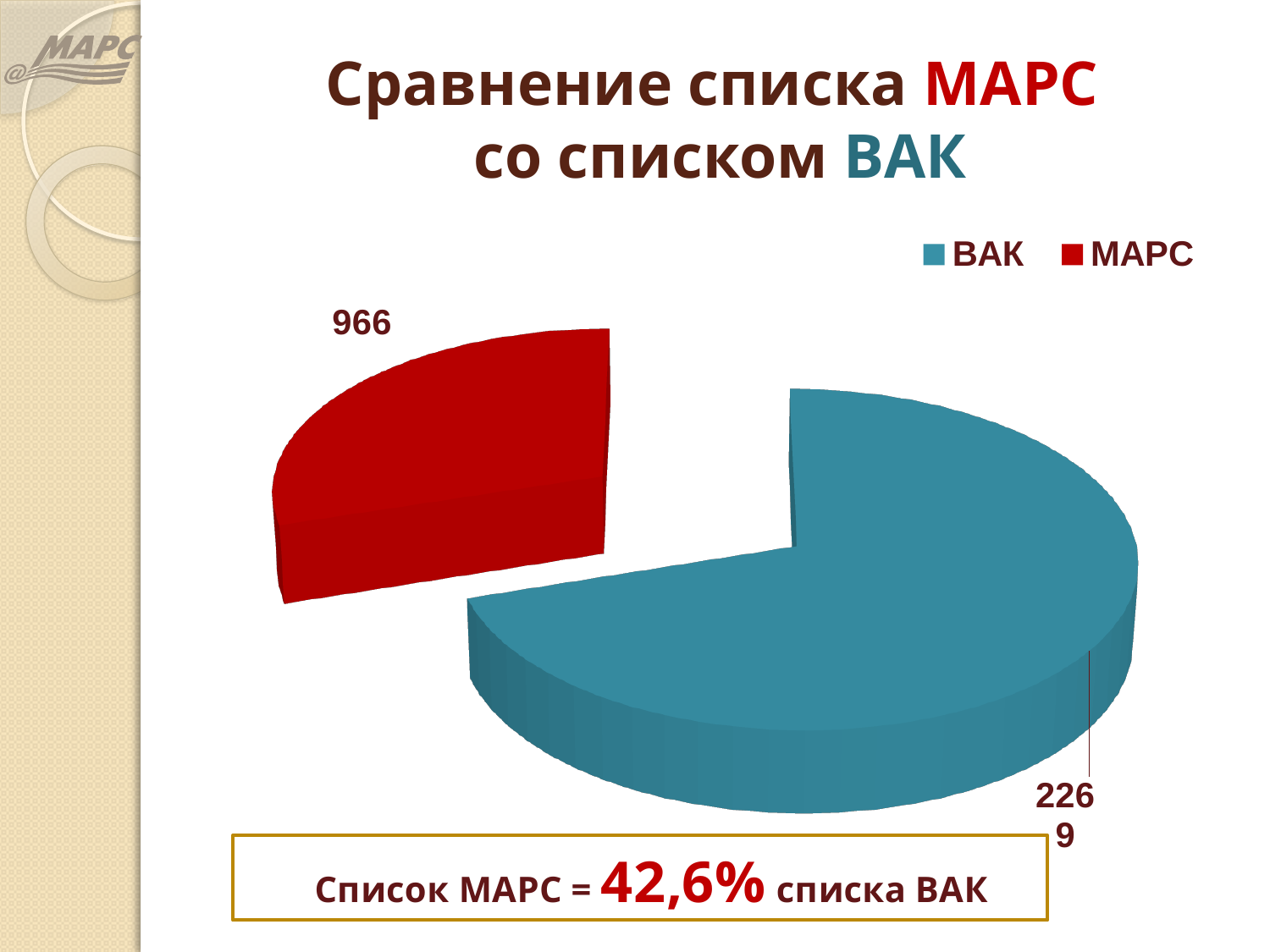
How many slices does the pie chart have? 2 What kind of chart is shown on the slide? Pie chart How many entries does the legend list? 2 What value is shown for the МАРС slice of the pie chart? 966 What is the difference between the ВАК value and the МАРС value? 1303 According to the text box below the chart, the МАРС list equals what percentage of the ВАК list? 42,6% What value is shown for the ВАК slice of the pie chart? 2269 Which slice of the pie chart is the smallest? МАРС Which slice of the pie chart is the largest? ВАК What is the total of the two slices in the pie chart? 3235 What colour is the МАРС slice in the pie chart? Red Which is larger, the value for ВАК or the value for МАРС? ВАК